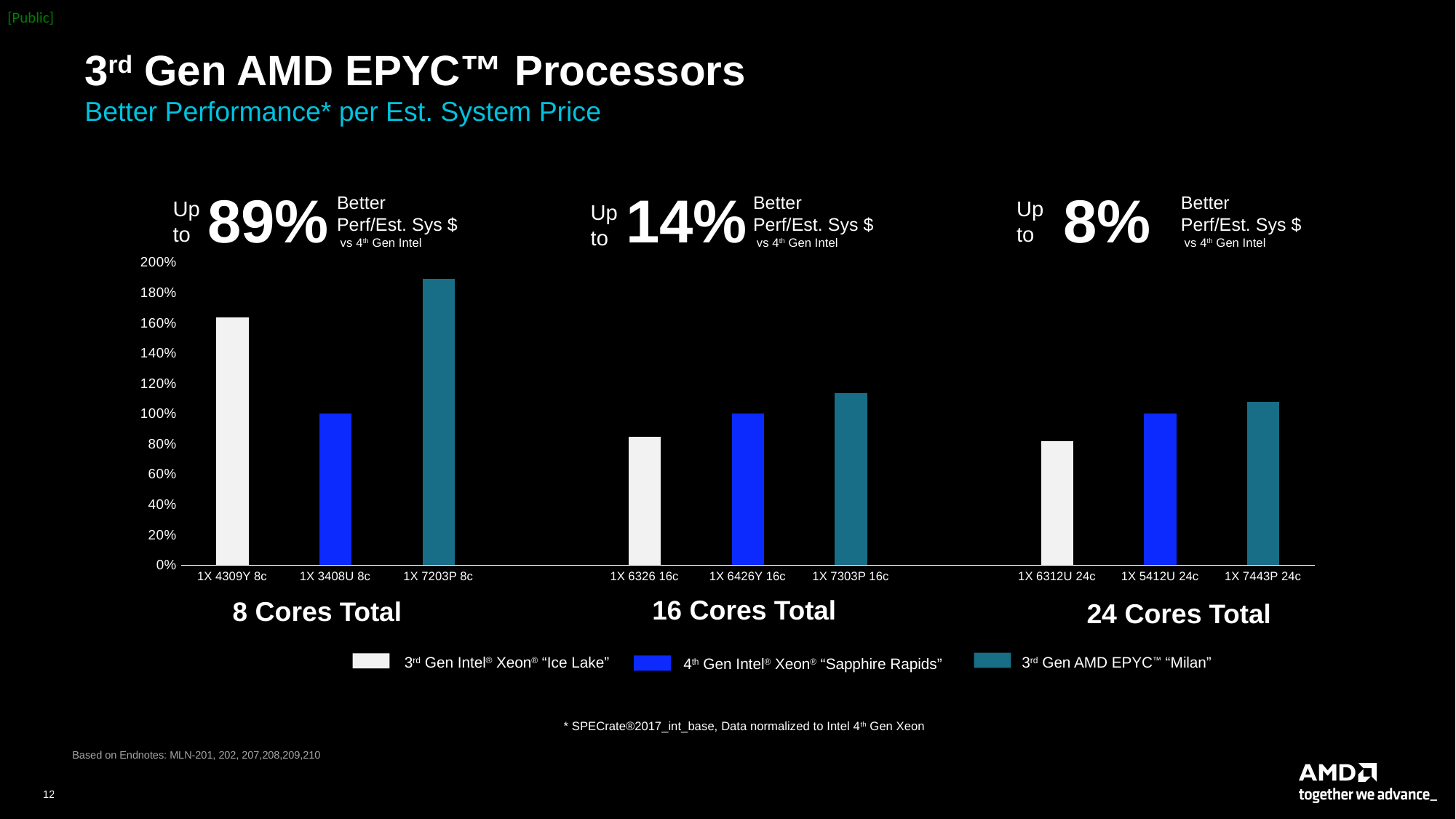
How many processor configurations (bars) are plotted on the x axis? 9 Within the 8 Cores Total group, which configuration has the lowest bar? 1X 3408U 8c Which processor configuration has the highest bar in the chart? 1X 7203P 8c Is the value for 1X 4309Y 8c greater or less than 140%? greater What kind of chart is shown on the slide? bar chart What is the value for 1X 6426Y 16c? 100% How many series does the legend list? 3 Is the value for 1X 7203P 8c greater or less than 180%? greater Is the value for 1X 6326 16c greater or less than 100%? less Which is larger, the value for 1X 4309Y 8c or the value for 1X 7303P 16c? 1X 4309Y 8c What is the value for 1X 3408U 8c? 100% Which legend entry is represented by the bright blue bars? 4th Gen Intel Xeon "Sapphire Rapids"